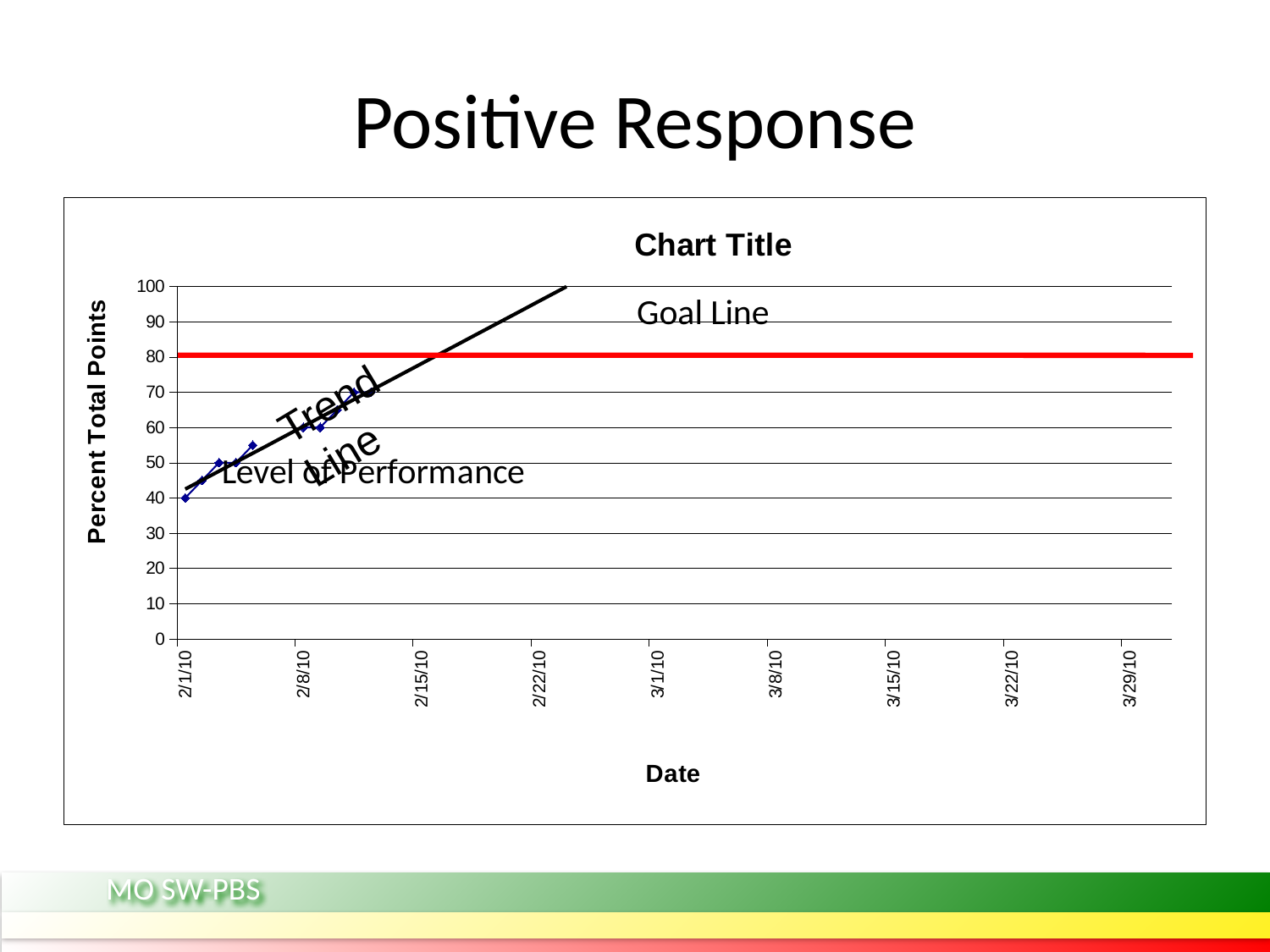
What kind of chart is shown on the slide? line chart What is the title of the x axis? Date What is the last date shown on the x axis? 3/29/10 Is the Goal Line greater or less than 70? greater Which is higher, the Goal Line or the Level of Performance value on 2/1/10? Goal Line What is the Level of Performance value on 2/1/10? 40 Is the Level of Performance value on 2/1/10 greater or less than 50? less What value does the red Goal Line sit at on the y axis? 80 Do the Level of Performance values rise or fall over the dates shown? rise What is the title of the y axis? Percent Total Points What is the first date shown on the x axis? 2/1/10